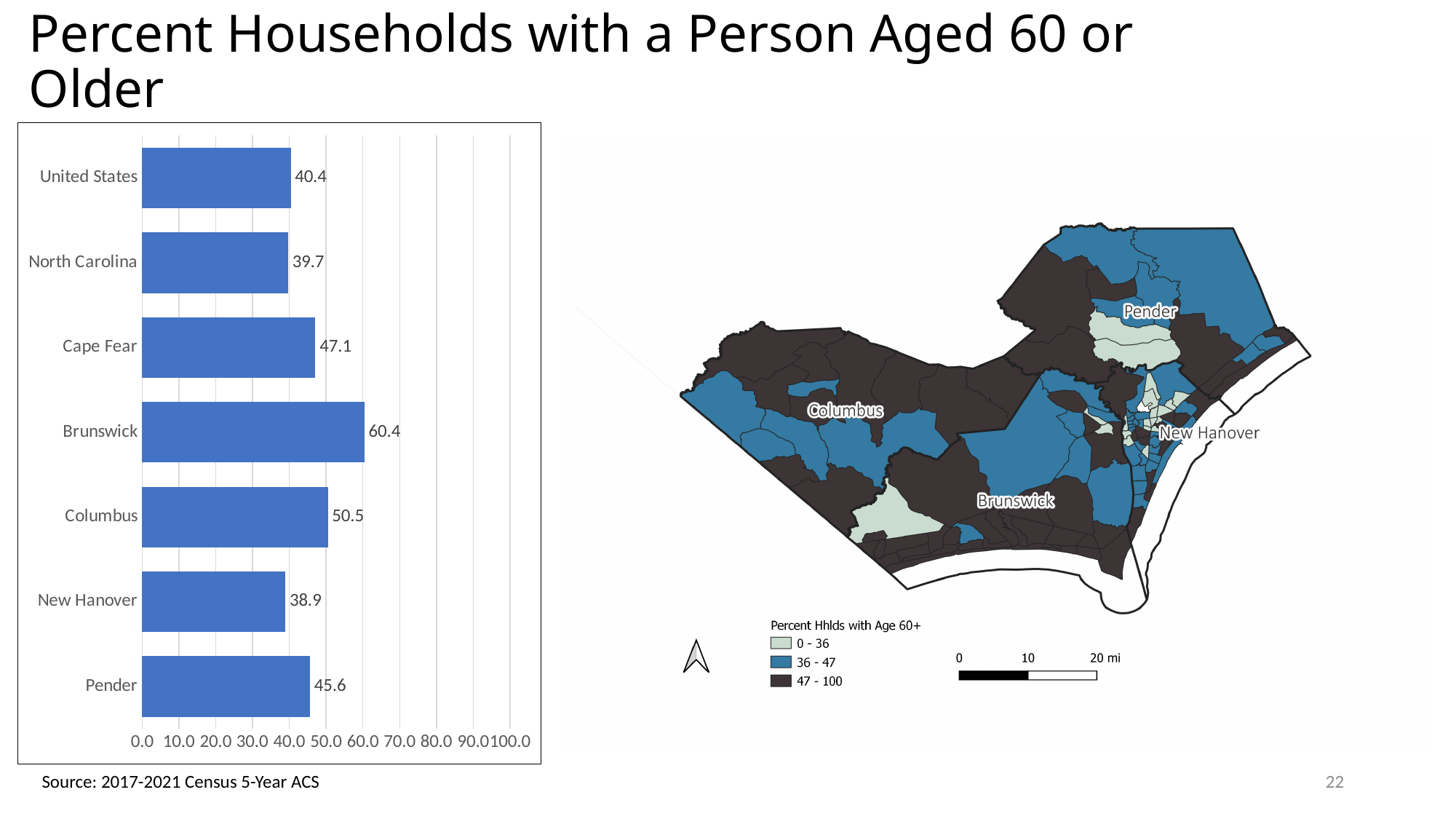
Which category has the lowest value in the bar chart? New Hanover What is the difference between the values for Brunswick and Columbus in the bar chart? 9.9 Which category has the highest value in the bar chart? Brunswick What is the difference between the values for Cape Fear and North Carolina in the bar chart? 7.4 What is the value for New Hanover in the bar chart? 38.9 What is the value for Brunswick in the bar chart? 60.4 What is the value for the United States in the bar chart? 40.4 What is the title of the slide containing the bar chart? Percent Households with a Person Aged 60 or Older What kind of chart is shown on the left of the slide? Bar chart What is the value for Pender in the bar chart? 45.6 How many categories are shown in the bar chart? 7 Which is larger in the bar chart, the value for Pender or the value for North Carolina? Pender